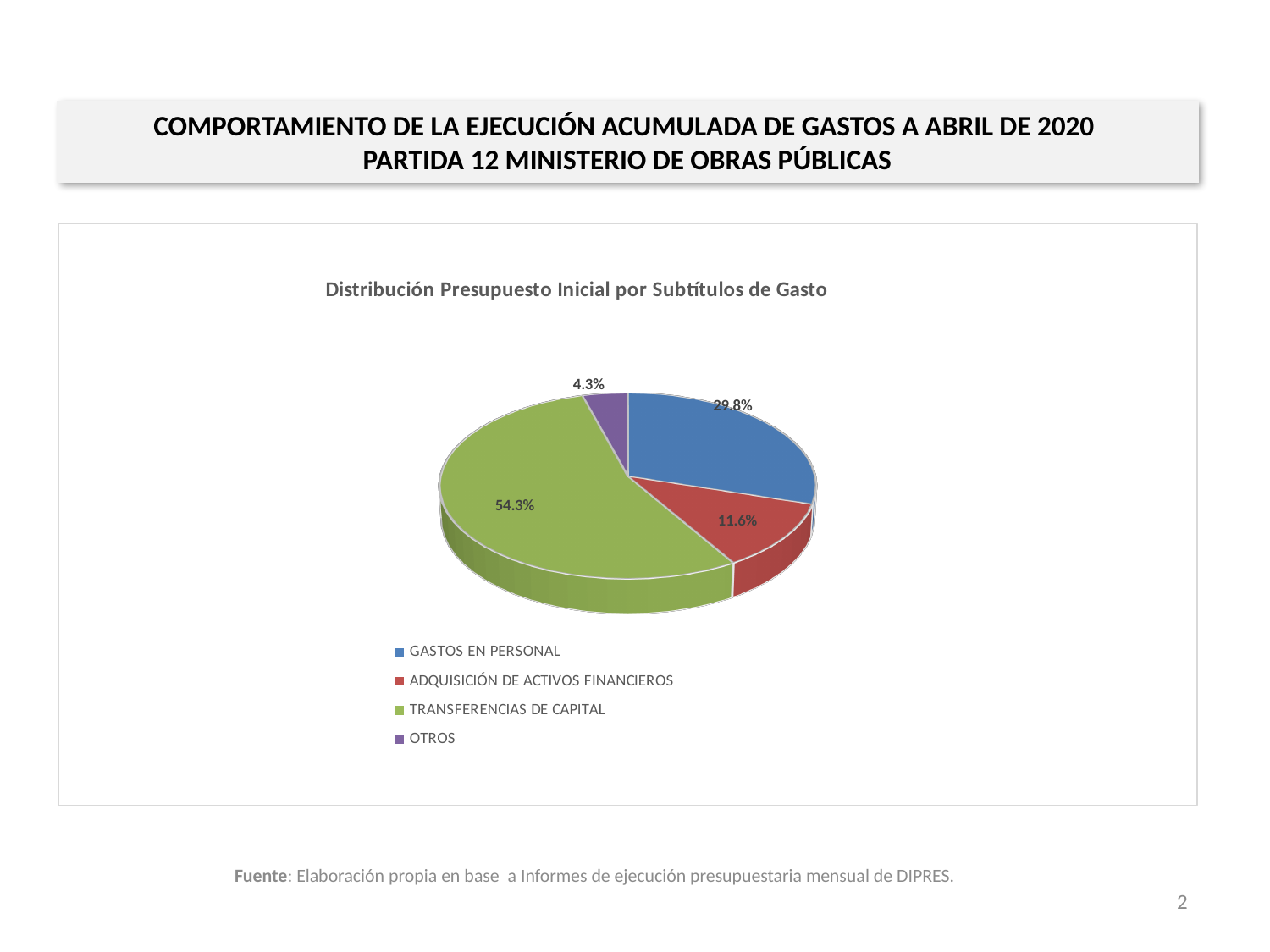
Which category has the largest slice of the pie? TRANSFERENCIAS DE CAPITAL What colour is the slice for TRANSFERENCIAS DE CAPITAL? Green Which is larger, the share for GASTOS EN PERSONAL or the share for ADQUISICIÓN DE ACTIVOS FINANCIEROS? GASTOS EN PERSONAL What is the title of the chart? Distribución Presupuesto Inicial por Subtítulos de Gasto How many categories does the legend list? 4 Which category has the smallest slice of the pie? OTROS What share of the pie does GASTOS EN PERSONAL represent? 29.8% What share of the pie does TRANSFERENCIAS DE CAPITAL represent? 54.3% What is the difference between the shares of TRANSFERENCIAS DE CAPITAL and GASTOS EN PERSONAL? 24.5% What is the value shown for OTROS? 4.3% What type of chart is shown on the slide? Pie chart What is the value shown for ADQUISICIÓN DE ACTIVOS FINANCIEROS? 11.6%